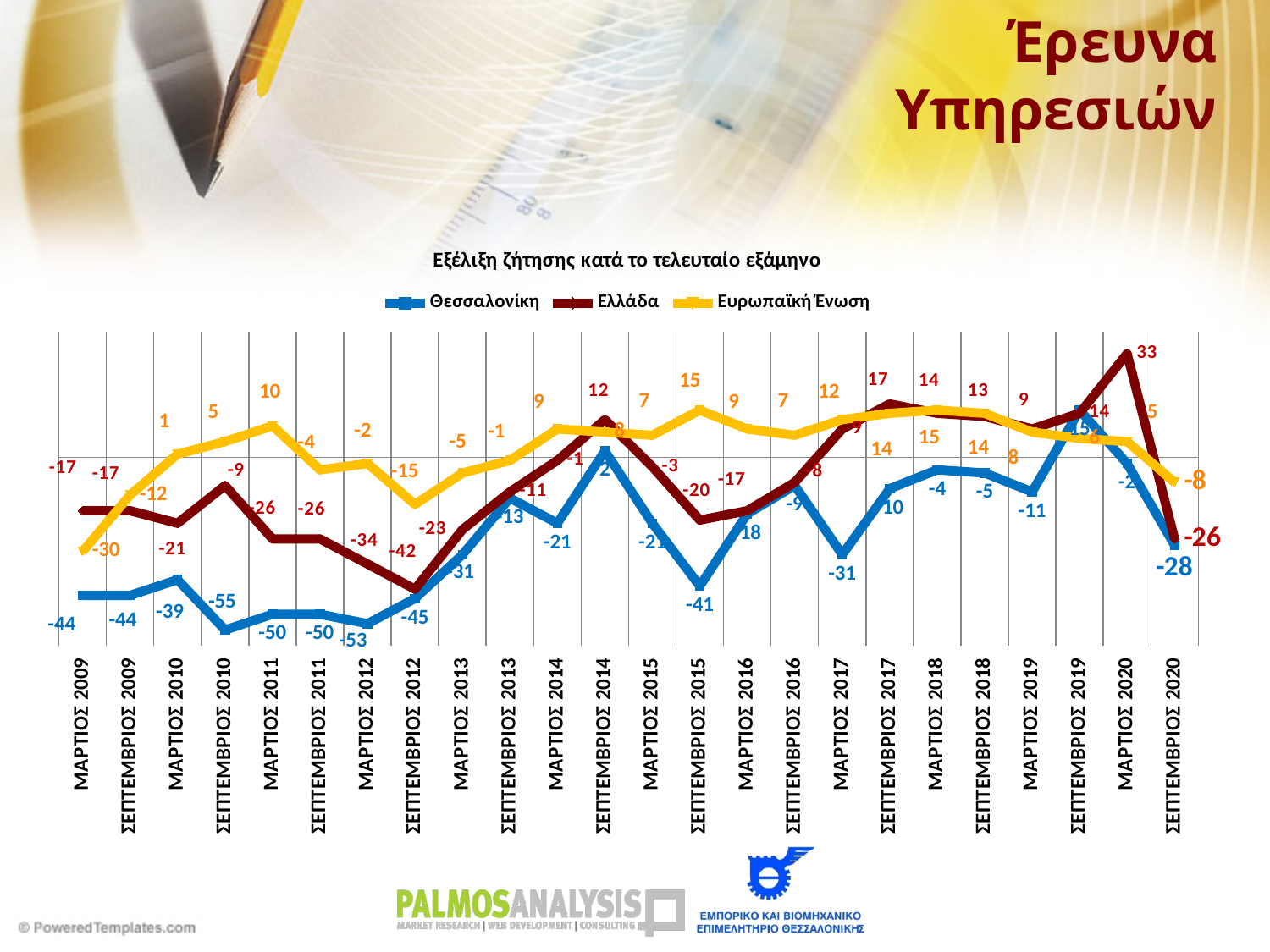
In which period does the Ελλάδα series reach its highest value? ΜΑΡΤΙΟΣ 2020 How many series does the legend list? 3 What is the title of the chart? Εξέλιξη ζήτησης κατά το τελευταίο εξάμηνο What is the value for Ελλάδα in ΜΑΡΤΙΟΣ 2020? 33 What kind of chart is shown on the slide? line chart In ΣΕΠΤΕΜΒΡΙΟΣ 2015, which is larger: the value for Θεσσαλονίκη or for Ελλάδα? Ελλάδα In which period does the Θεσσαλονίκη series reach its lowest value? ΣΕΠΤΕΜΒΡΙΟΣ 2010 By how much did the Ελλάδα value fall from ΜΑΡΤΙΟΣ 2020 to ΣΕΠΤΕΜΒΡΙΟΣ 2020? 59 What is the value for Ελλάδα in ΣΕΠΤΕΜΒΡΙΟΣ 2020? -26 How many time points are shown on the x axis? 24 What is the value for Θεσσαλονίκη in ΜΑΡΤΙΟΣ 2009? -44 What is the value for Θεσσαλονίκη in ΣΕΠΤΕΜΒΡΙΟΣ 2015? -41